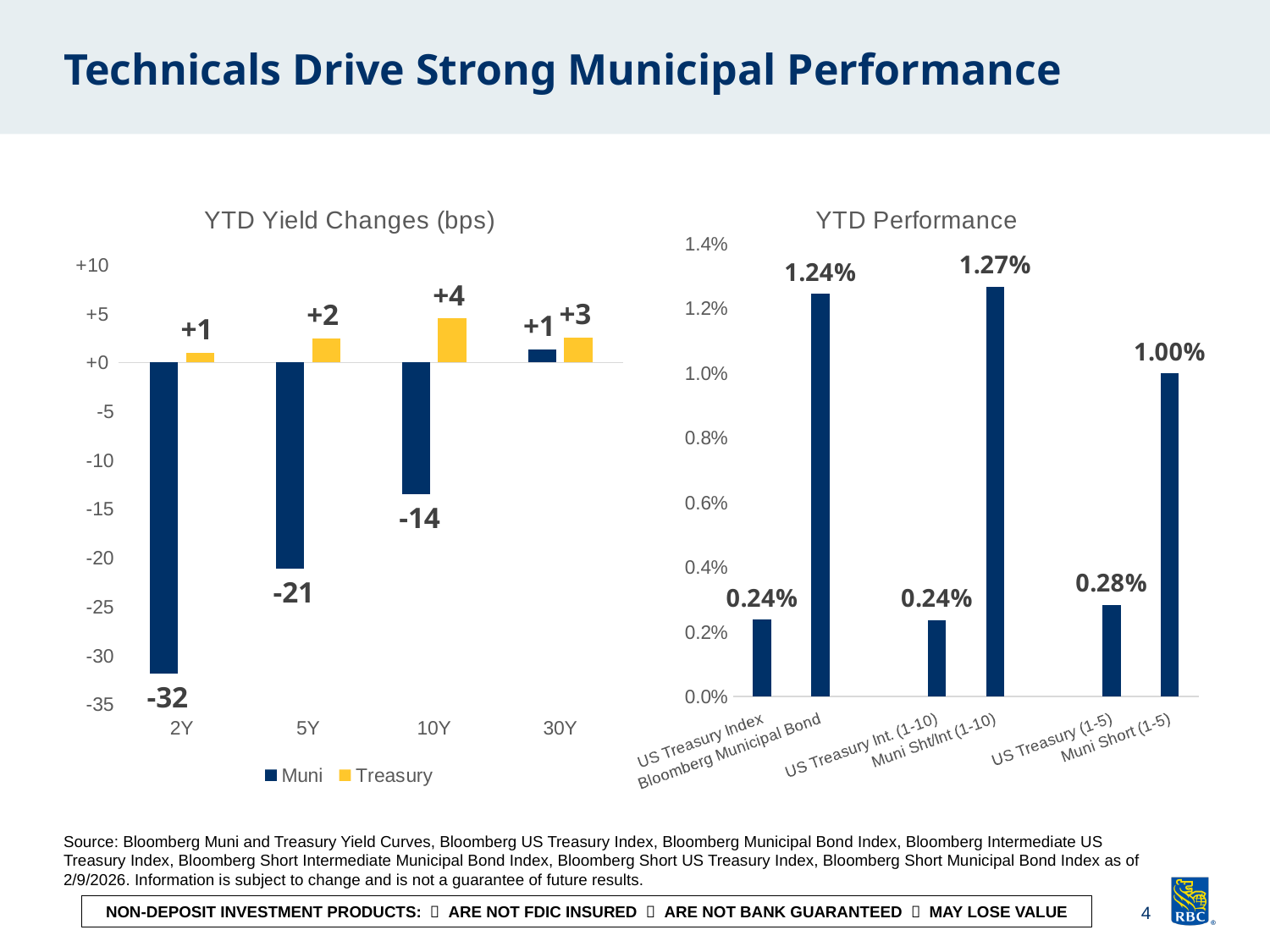
In the YTD Yield Changes (bps) chart, do the Muni values rise or fall from 2Y to 30Y? rise In the YTD Performance chart, what is the value for US Treasury (1-5)? 0.28% In the YTD Yield Changes (bps) chart, how many series does the legend list? 2 In the YTD Performance chart, how many categories are shown? 6 In the YTD Performance chart, what is the value for Muni Sht/Int (1-10)? 1.27% In the YTD Performance chart, which category has the highest value? Muni Sht/Int (1-10) In the YTD Yield Changes (bps) chart, what is the Treasury value for 10Y? +4 In the YTD Yield Changes (bps) chart, what is the difference between the Treasury and Muni values at 5Y? 23 In the YTD Yield Changes (bps) chart, what is the Muni value for 2Y? -32 In the YTD Yield Changes (bps) chart, which maturity has the lowest Muni value? 2Y In the YTD Performance chart, which is larger, Bloomberg Municipal Bond or US Treasury Index? Bloomberg Municipal Bond What kind of chart is the YTD Performance chart? bar chart